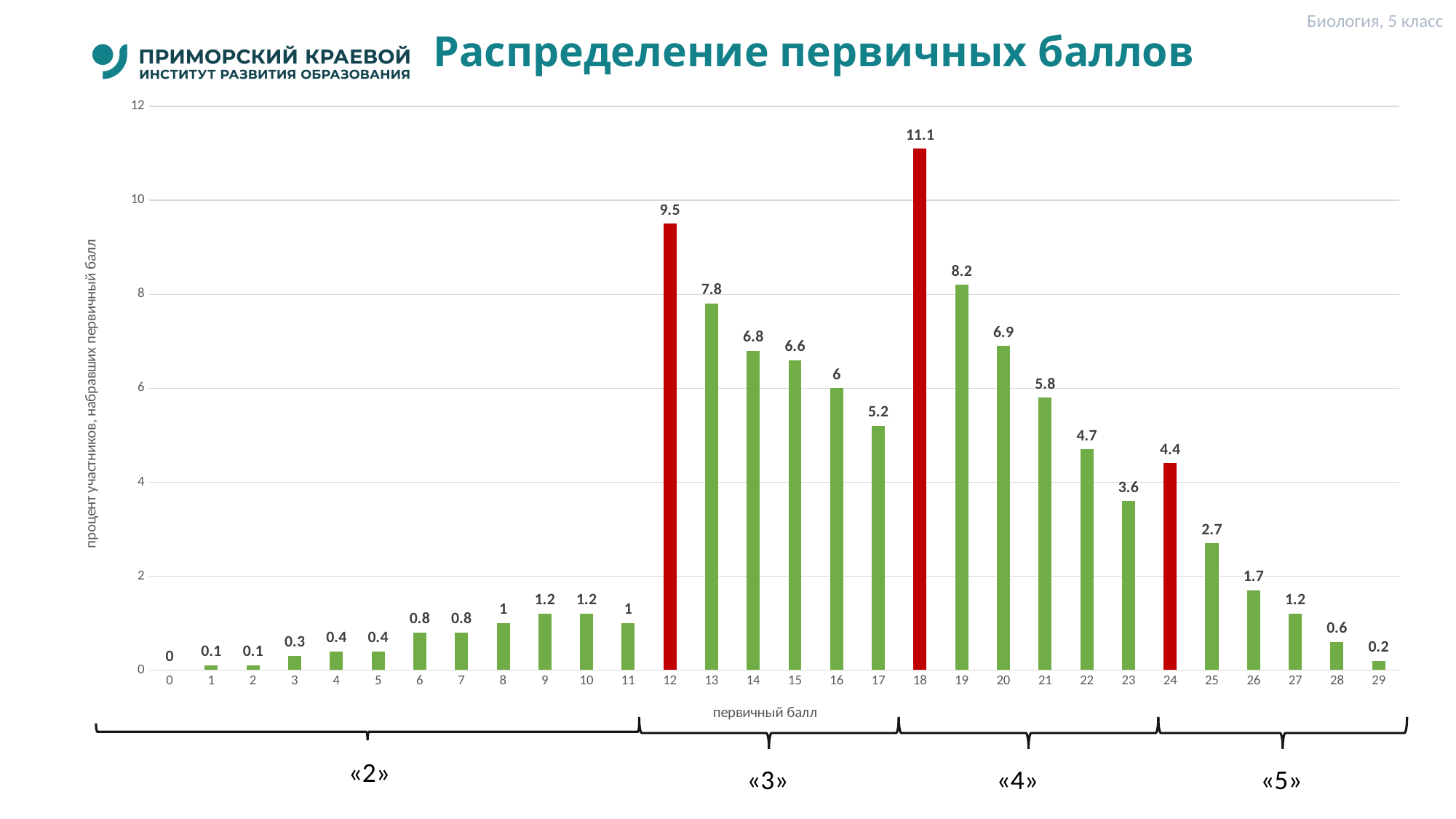
Which is larger, the value for primary score 13 or for primary score 19? 19 Do the values rise or fall from primary score 18 to primary score 29? fall Which primary score has the lowest percentage of participants? 0 What is the value for primary score 12? 9.5 Is the value for primary score 20 greater or less than 6? greater What type of chart is shown on the slide? bar chart What is the value for primary score 24? 4.4 How many primary score categories are shown on the x axis? 30 What is the title of the chart? Распределение первичных баллов Which primary score has the highest percentage of participants? 18 What is the value for primary score 18? 11.1 What is the difference between the values for primary scores 18 and 12? 1.6